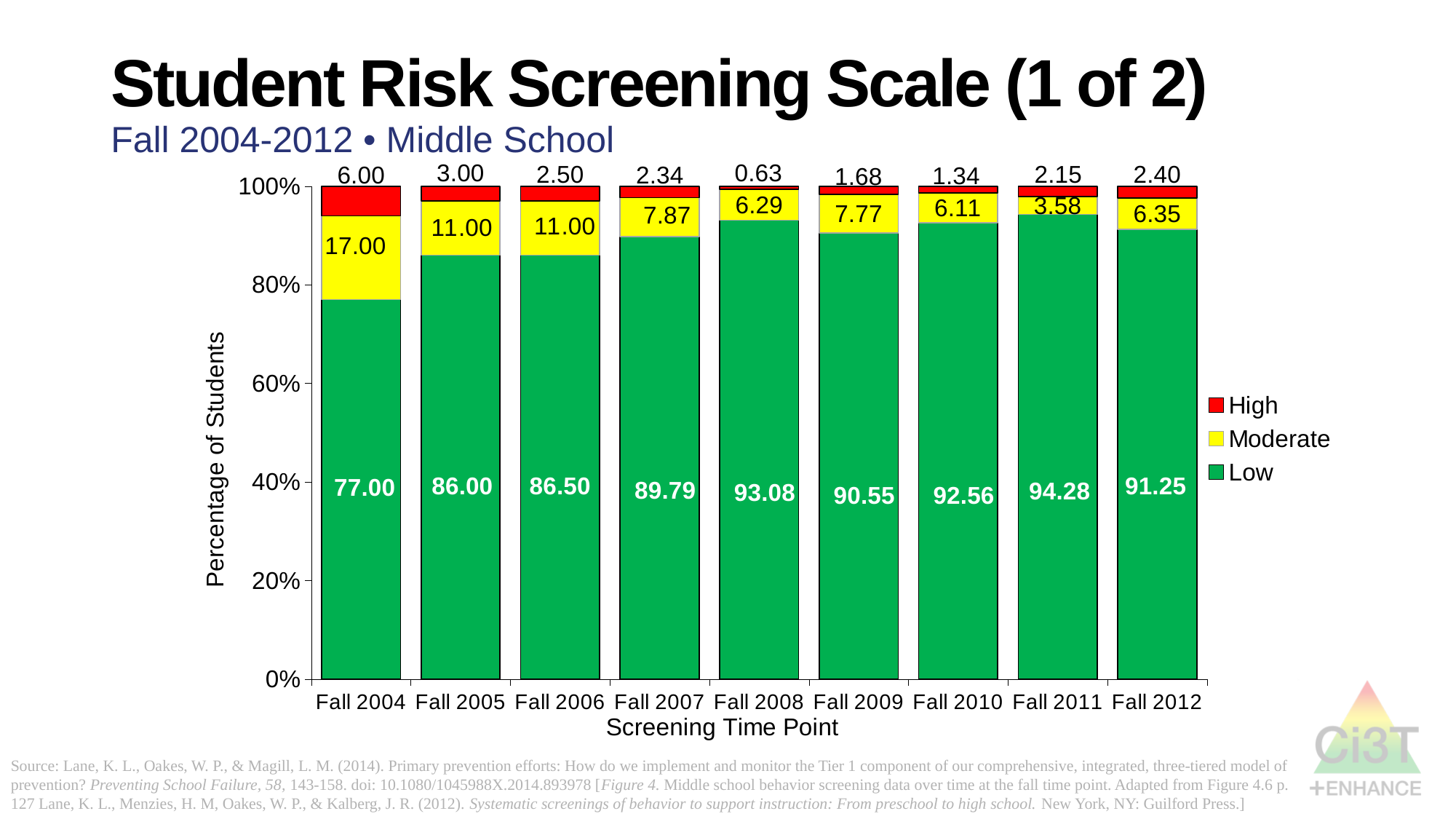
What kind of chart is shown on the slide? Stacked bar chart What is the Moderate value for Fall 2004? 17.00 How many screening time points are shown on the x axis? 9 Which screening time point has the highest Low value? Fall 2011 What is the difference between the Low values for Fall 2005 and Fall 2004? 9.00 What is the High value for Fall 2010? 1.34 How many series does the legend list? 3 Which screening time point has the lowest Moderate value? Fall 2011 Which has the larger Low value, Fall 2010 or Fall 2012? Fall 2010 What is the Low value for Fall 2008? 93.08 Which screening time point has the highest High value? Fall 2004 Which screening time point has the lowest High value? Fall 2008